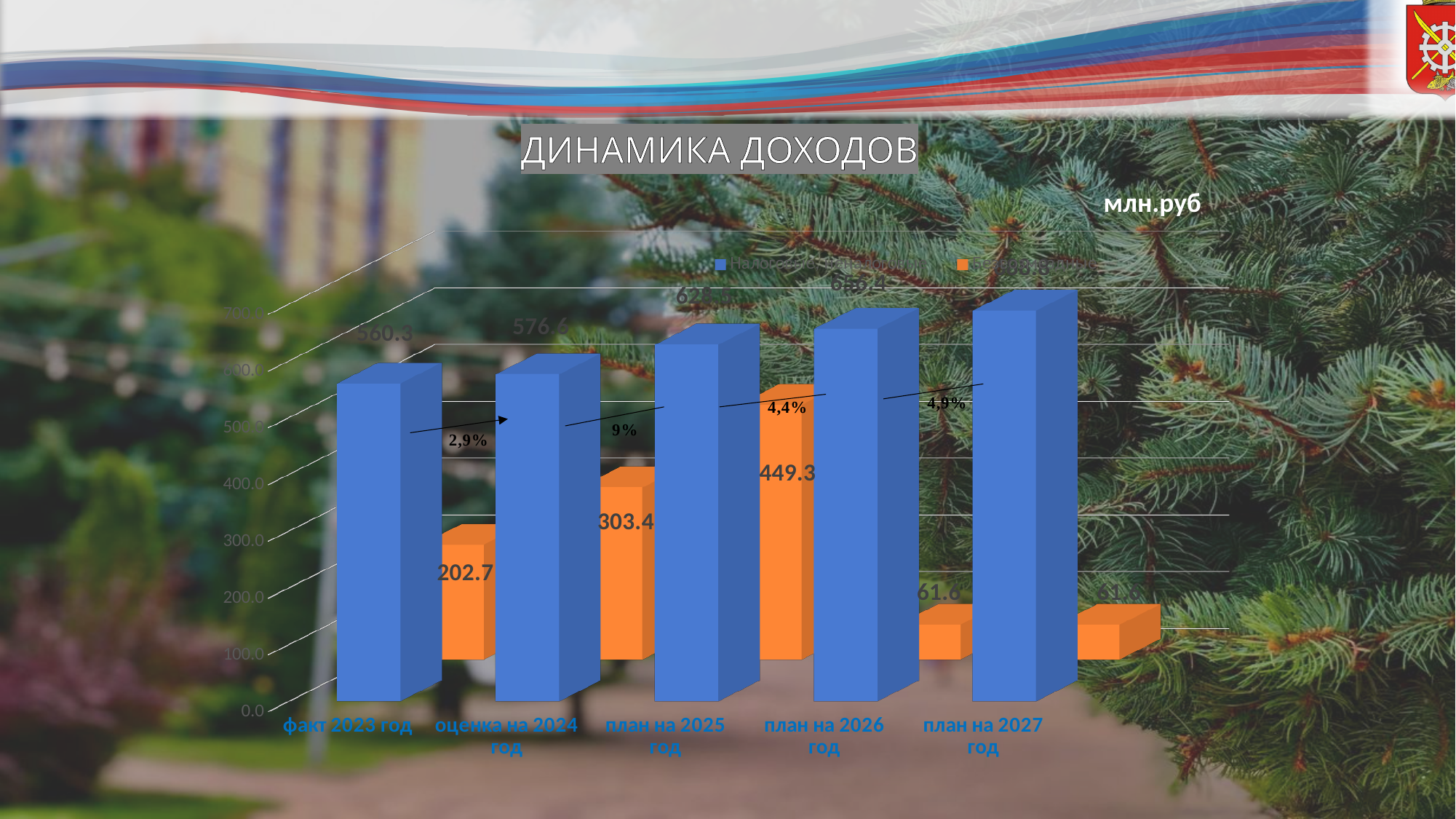
Which is larger: the orange bar for оценка на 2024 год or the orange bar for факт 2023 год? оценка на 2024 год What is the value of the orange bar for факт 2023 год? 202.7 What is the difference between the orange values for план на 2025 год and оценка на 2024 год? 145.9 What is the value of the orange bar for план на 2026 год? 61.6 Is the value of the blue bar for план на 2027 год greater or less than 600.0? greater How many categories are shown on the x axis? 5 Do the blue bars rise or fall from факт 2023 год to план на 2027 год? rise What is the value of the blue bar for факт 2023 год? 560.3 What is the value of the blue bar for оценка на 2024 год? 576.6 What unit of measurement is indicated above the chart? млн.руб What is the value of the orange bar for план на 2025 год? 449.3 For which category is the orange bar highest? план на 2025 год